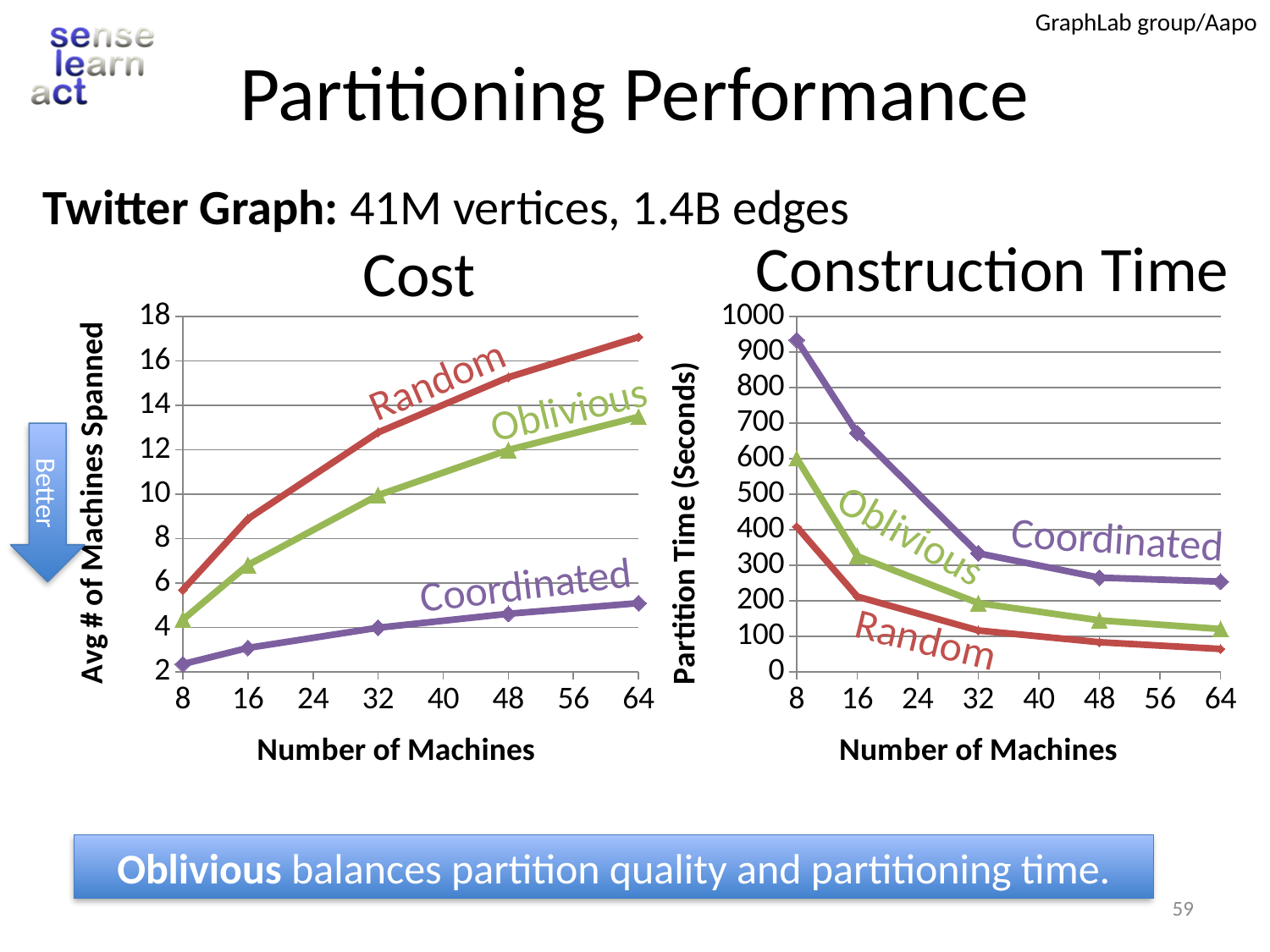
In the Construction Time chart, which series has the lowest value at 64 machines? Random What kind of chart is the Cost chart? line chart In the Cost chart, which series has the lowest value at 64 machines? Coordinated How many series are plotted in the Cost chart? 3 In the Construction Time chart, do the values for Coordinated rise or fall as the number of machines increases? fall In the Construction Time chart, which series has the highest value at 8 machines? Coordinated In the Construction Time chart, is the value for Random at 64 machines greater or less than 100? less In the Cost chart, which series has the highest value at 64 machines? Random In the Construction Time chart, is the value for Coordinated at 8 machines greater or less than 800? greater In the Cost chart, do the values for Random rise or fall as the number of machines increases? rise In the Cost chart, is the value for Random at 64 machines greater or less than 16? greater What kind of chart is the Construction Time chart? line chart